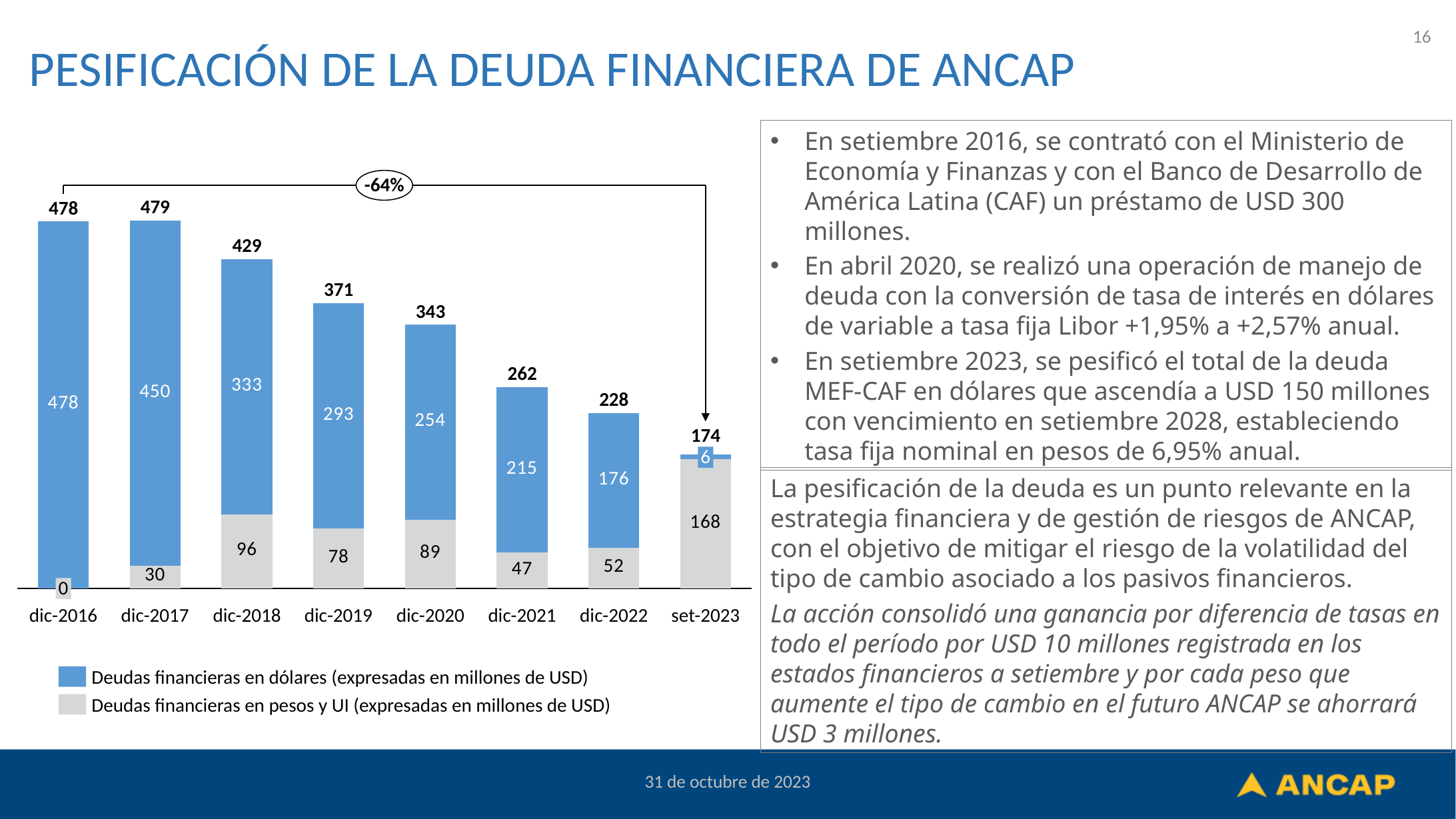
What percentage change is annotated between dic-2016 and set-2023? -64% How many series does the legend list? 2 What is the value of 'Deudas financieras en pesos y UI' for dic-2018? 96 What is the difference between the total for dic-2016 and the total for set-2023? 304 What is the total of the stacked bar for set-2023? 174 Which period has the highest total financial debt? dic-2017 What is the value of 'Deudas financieras en dólares' for dic-2019? 293 Do the total values rise or fall from dic-2017 to set-2023? Fall How many periods are shown on the x axis? 8 Which period has the lowest total financial debt? set-2023 Which is larger: 'Deudas financieras en dólares' for dic-2020 or for dic-2021? dic-2020 What kind of chart is shown on the slide? Stacked bar chart